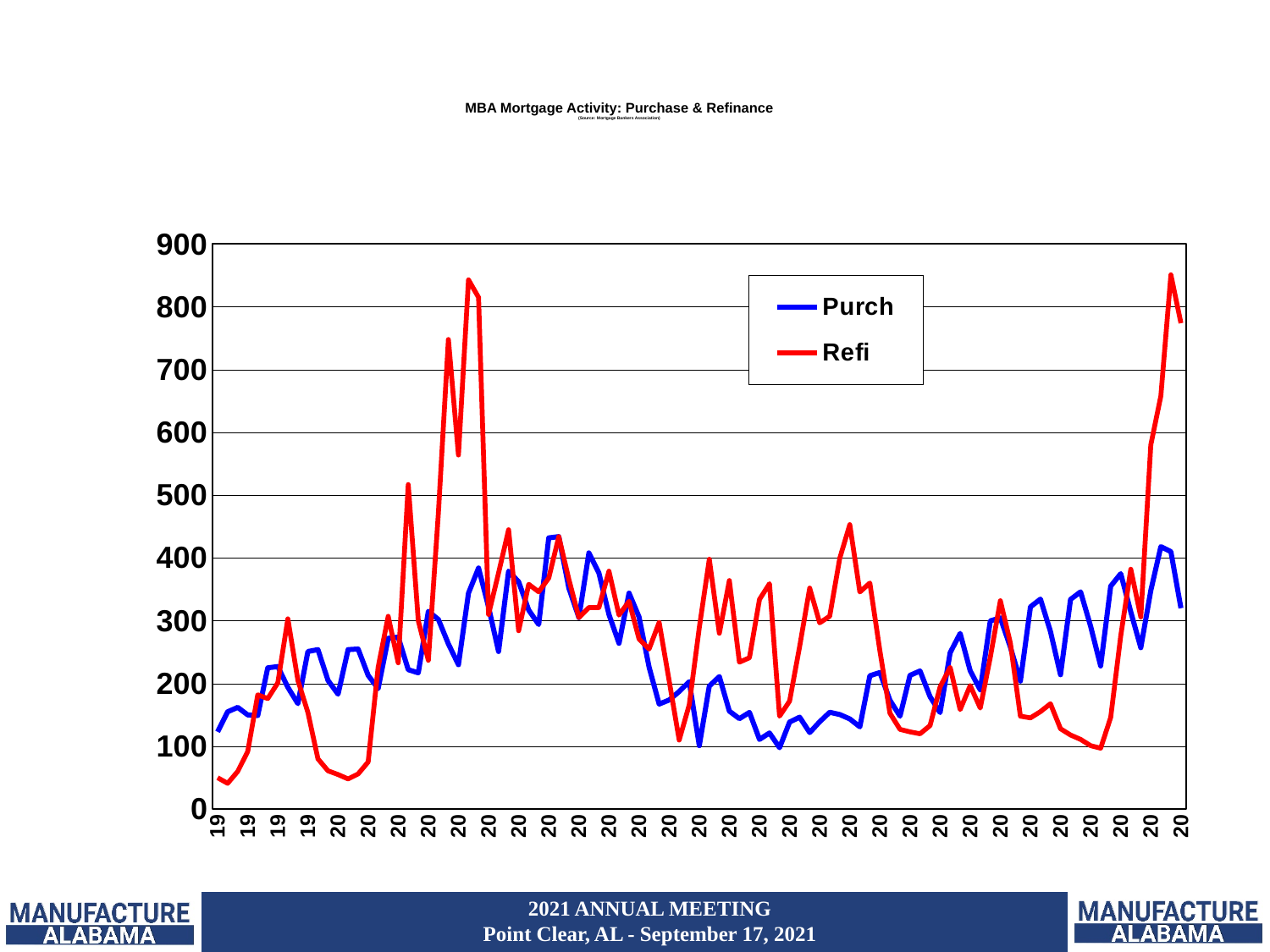
Is the highest value of the Purch series greater or less than 500? less Which series drops to the lowest value on the chart, Purch or Refi? Refi Which series reaches the higher peak value, Purch or Refi? Refi Is the highest value of the Purch series greater or less than 400? greater Is the lowest value of the Refi series greater or less than 100? less What is the title of the chart? MBA Mortgage Activity: Purchase & Refinance What kind of chart is shown on the slide? line chart How many series does the legend list? 2 What are the two series named in the legend? Purch and Refi